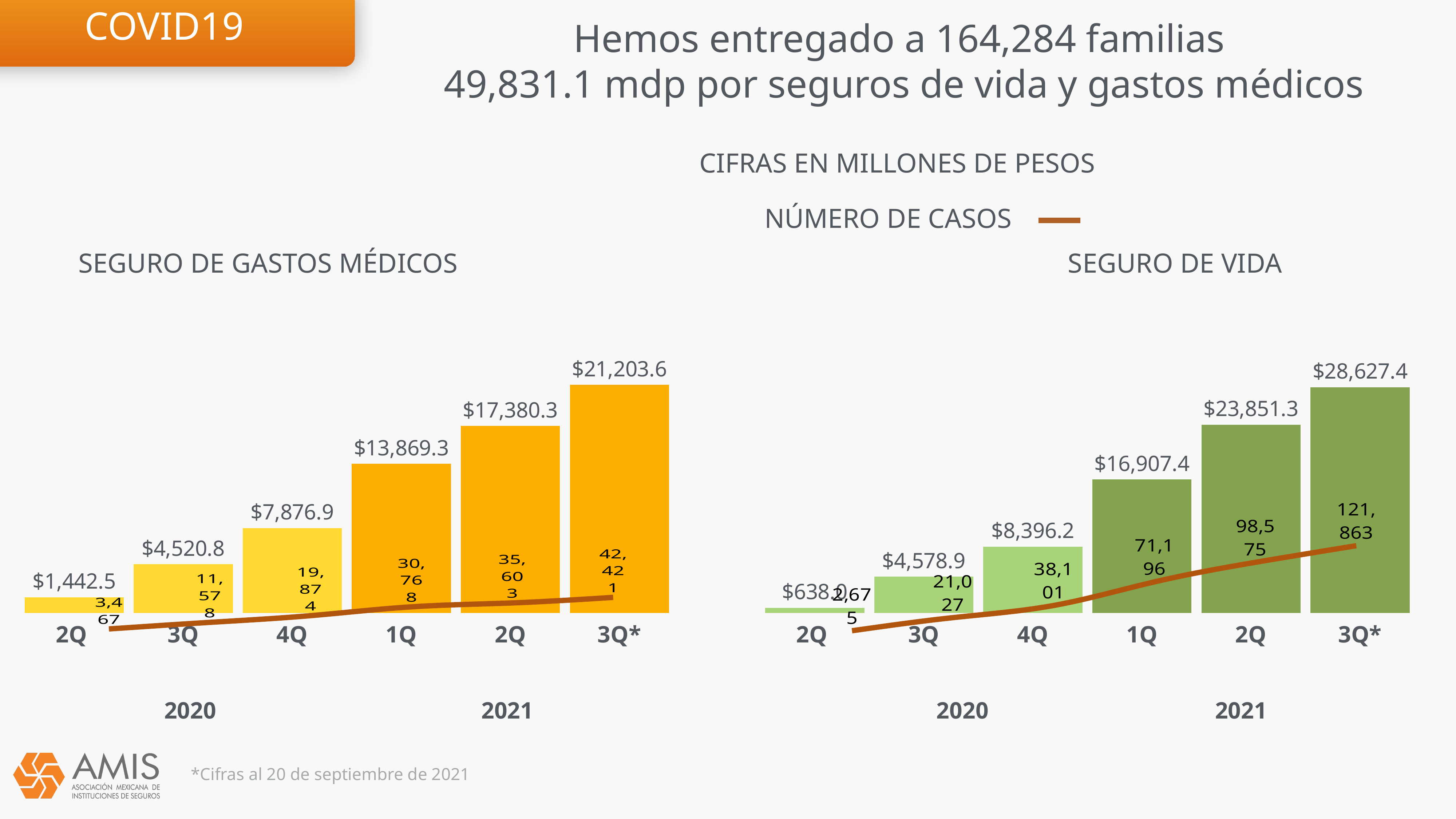
In the SEGURO DE GASTOS MÉDICOS chart, what is the value for 4Q 2020? $7,876.9 Which is larger: the 3Q* 2021 value in the SEGURO DE VIDA chart or the 3Q* 2021 value in the SEGURO DE GASTOS MÉDICOS chart? SEGURO DE VIDA In the SEGURO DE GASTOS MÉDICOS chart, what is the value for 3Q* 2021? $21,203.6 What type of chart is the SEGURO DE VIDA chart? Bar chart with a line In the SEGURO DE VIDA chart, what is the value for 1Q 2021? $16,907.4 How many quarters are shown in the SEGURO DE GASTOS MÉDICOS chart? 6 In the SEGURO DE VIDA chart, which quarter has the highest value? 3Q* 2021 In the SEGURO DE GASTOS MÉDICOS chart, which quarter has the lowest value? 2Q 2020 In the SEGURO DE VIDA chart, what is the difference between the 3Q* 2021 value and the 2Q 2021 value? $4,776.1 What does the brown line in the charts represent, according to the legend? NÚMERO DE CASOS In the SEGURO DE GASTOS MÉDICOS chart, what is the difference between the 2Q 2021 value and the 1Q 2021 value? $3,511.0 In the SEGURO DE VIDA chart, do the bar values rise or fall from 2Q 2020 to 3Q* 2021? Rise